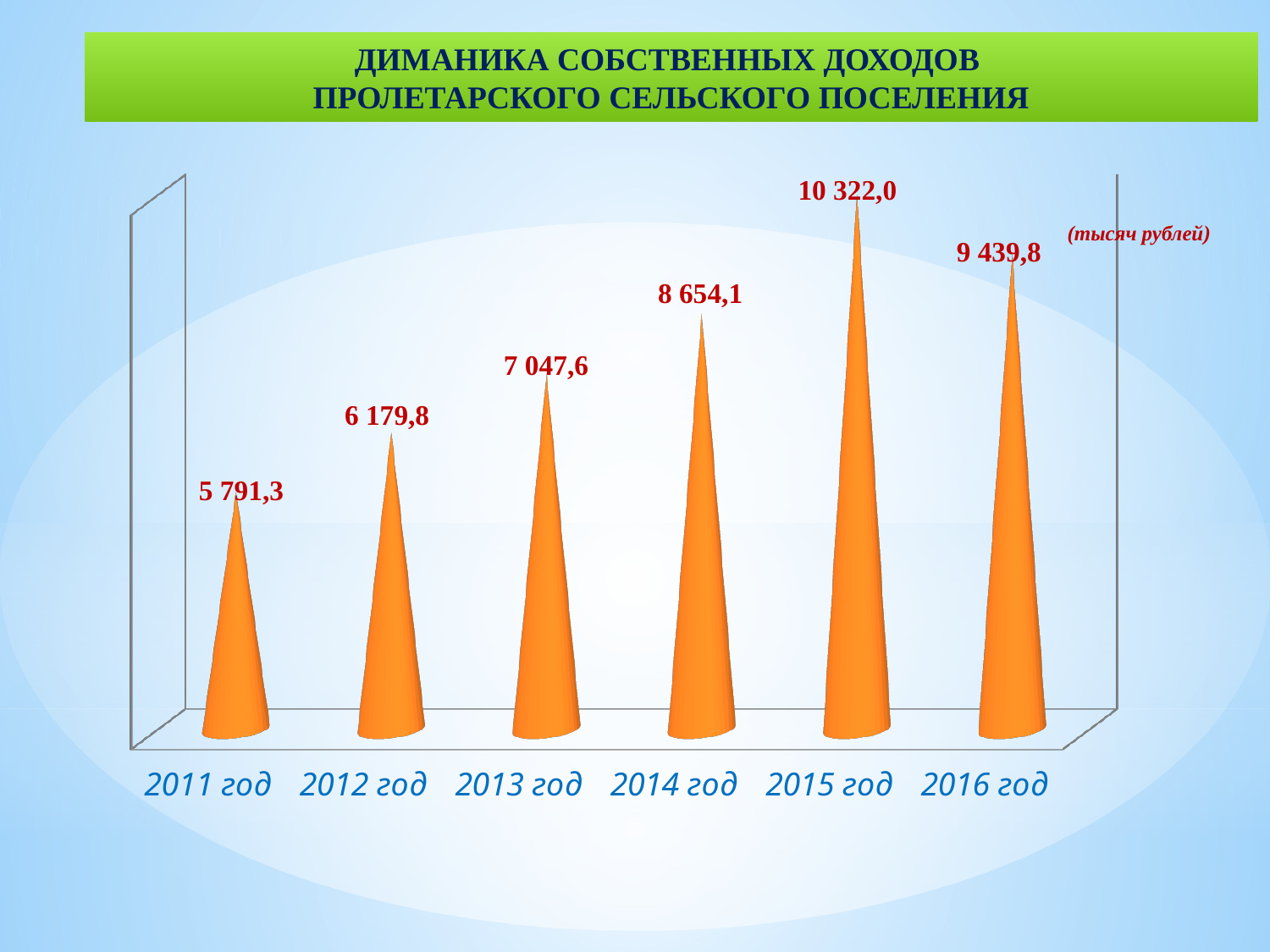
What is the difference between the values for 2015 год and 2014 год? 1 667,9 Do the values rise or fall from 2011 год to 2015 год? rise Which year has the lowest value? 2011 год Which is larger, the value for 2013 год or the value for 2012 год? 2013 год Which year has the highest value? 2015 год What is the value for 2014 год? 8 654,1 By how much does the value for 2015 год exceed the value for 2016 год? 882,2 What is the value for 2016 год? 9 439,8 How many years are shown on the chart? 6 What kind of chart is shown on the slide? bar chart What is the value for 2011 год? 5 791,3 In what units are the values on the chart given? тысяч рублей